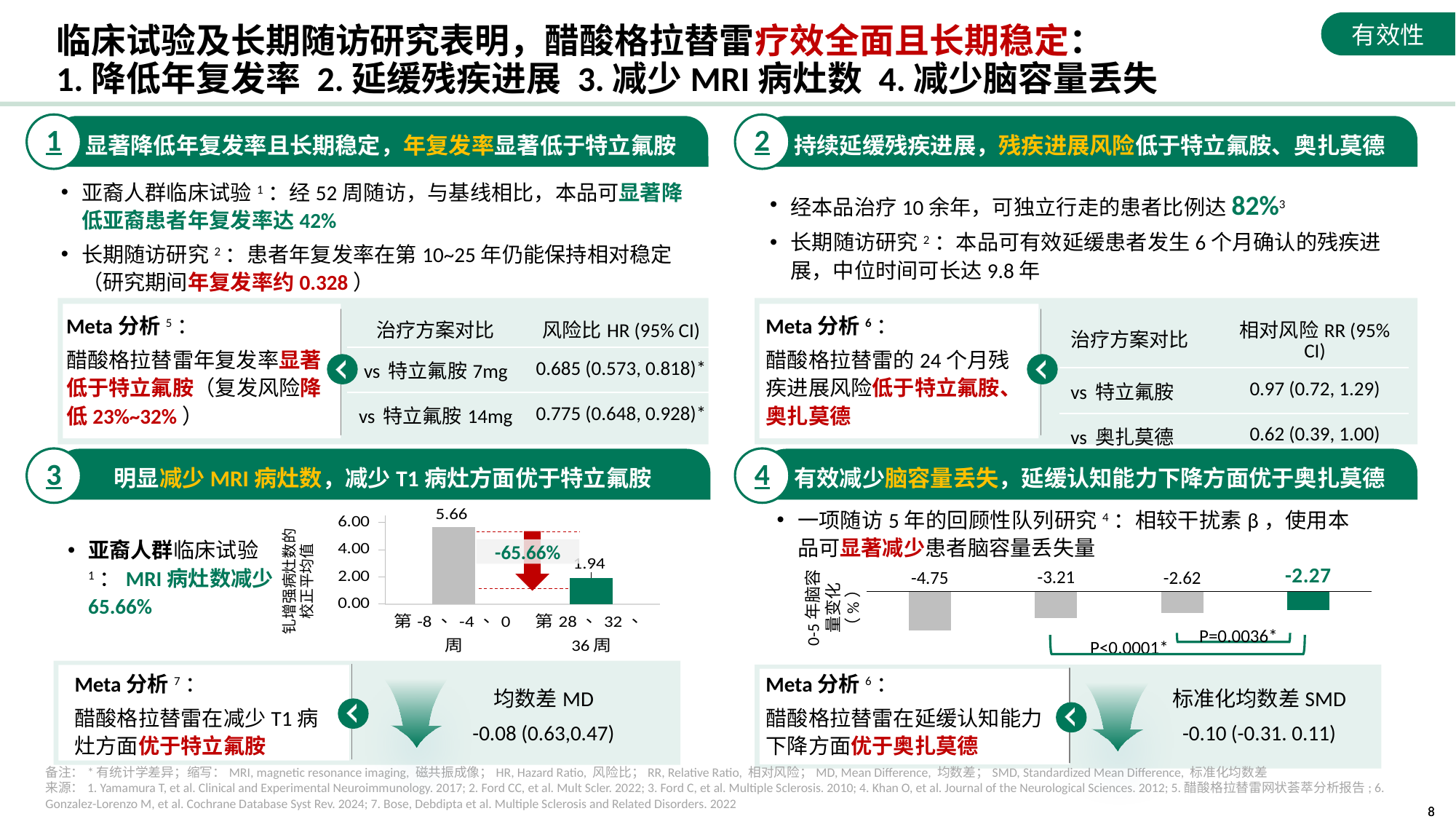
On the MRI lesion chart in section 3, what percentage change is annotated between the two bars? -65.66% On the brain volume change chart in section 4, what is the value of the leftmost bar? -4.75 On the MRI lesion chart in section 3, how many bars are plotted? 2 On the MRI lesion chart in section 3, which category has the higher value, 第 -8、-4、0 周 or 第 28、32、36 周? 第 -8、-4、0 周 On the brain volume change chart in section 4, how many bars are plotted? 4 On the MRI lesion chart in section 3, what is the value for 第 28、32、36 周? 1.94 What kind of chart is shown in section 3 (MRI 病灶数)? bar chart On the MRI lesion chart in section 3, what is the difference between the value for 第 -8、-4、0 周 and the value for 第 28、32、36 周? 3.72 On the MRI lesion chart in section 3, what is the value for 第 -8、-4、0 周? 5.66 On the brain volume change chart in section 4, which bar has the lowest value? the leftmost bar (-4.75) On the brain volume change chart in section 4, what is the value of the rightmost (green) bar? -2.27 On the brain volume change chart in section 4, do the values rise or fall from left to right? rise